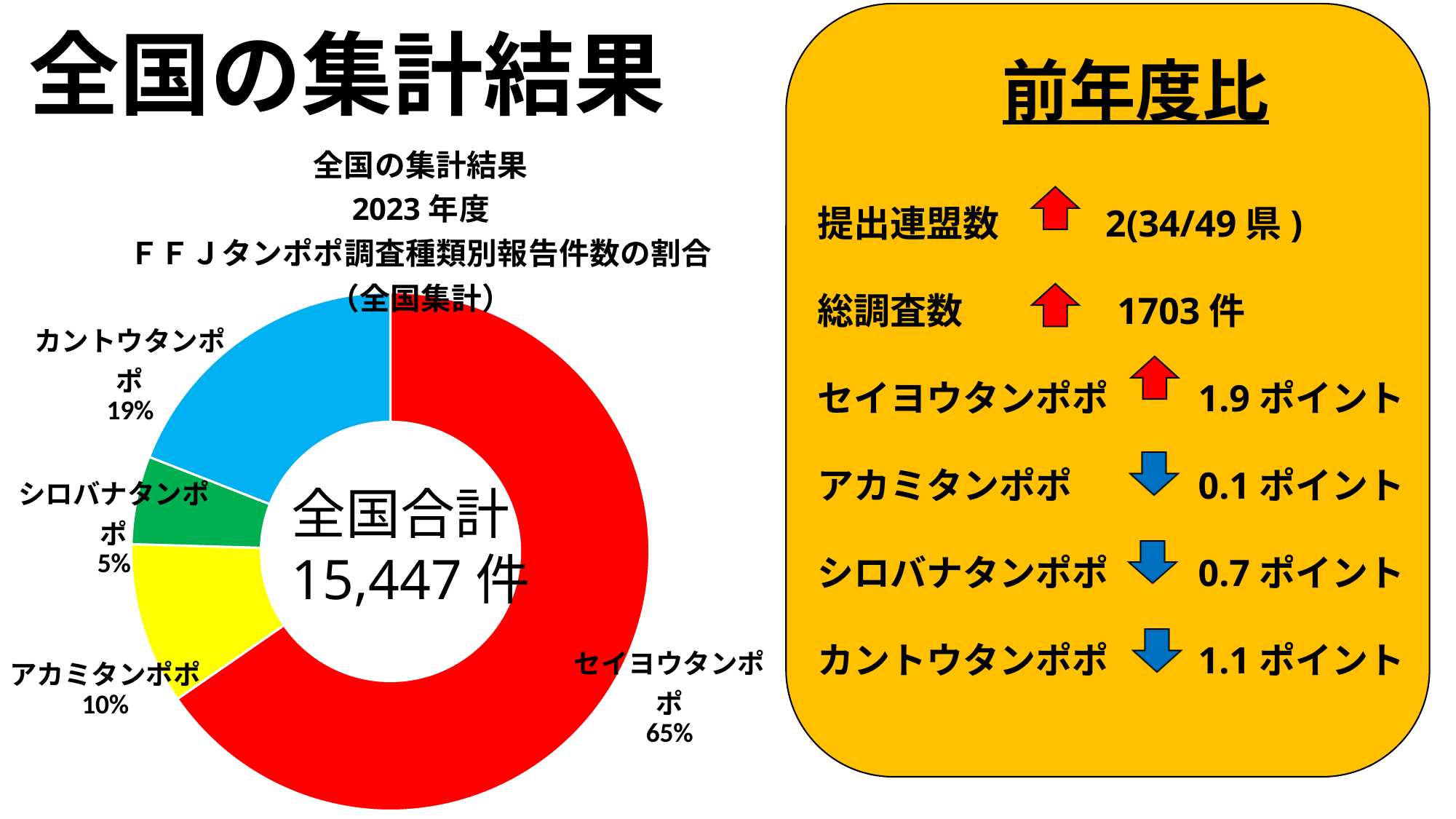
How many categories are shown in the chart? 4 Which category has the largest share of the chart? セイヨウタンポポ What is the difference in percentage points between セイヨウタンポポ and カントウタンポポ? 46 What kind of chart is shown on the slide? Doughnut (pie) chart What share of the chart does シロバナタンポポ have? 5% What share of the chart does アカミタンポポ have? 10% What total number of reports is shown in the centre of the chart? 15,447 件 What share of the chart does セイヨウタンポポ have? 65% What colour is the セイヨウタンポポ segment of the chart? Red Which category has the smallest share of the chart? シロバナタンポポ Which has a larger share, アカミタンポポ or シロバナタンポポ? アカミタンポポ